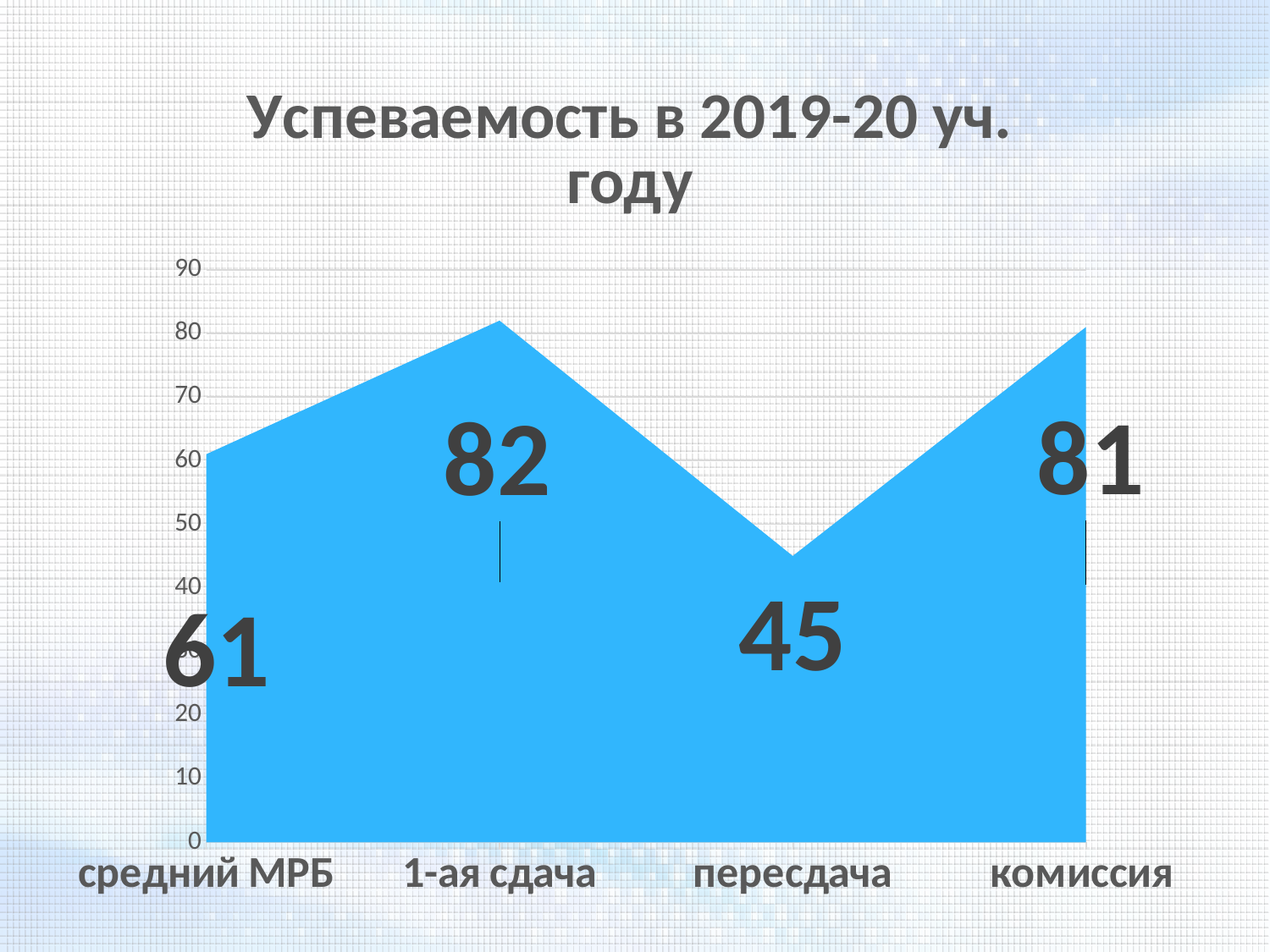
What is the difference between the values for 1-ая сдача and пересдача? 37 What is the value for средний МРБ? 61 What kind of chart is shown on the slide? area chart Which category has the lowest value? пересдача What is the value for комиссия? 81 How many categories are shown on the x axis? 4 What is the value for 1-ая сдача? 82 What is the value for пересдача? 45 Is the value for пересдача greater or less than 50? less Which is larger, the value for средний МРБ or the value for пересдача? средний МРБ What is the title of the chart? Успеваемость в 2019-20 уч. году What is the difference between the values for комиссия and средний МРБ? 20